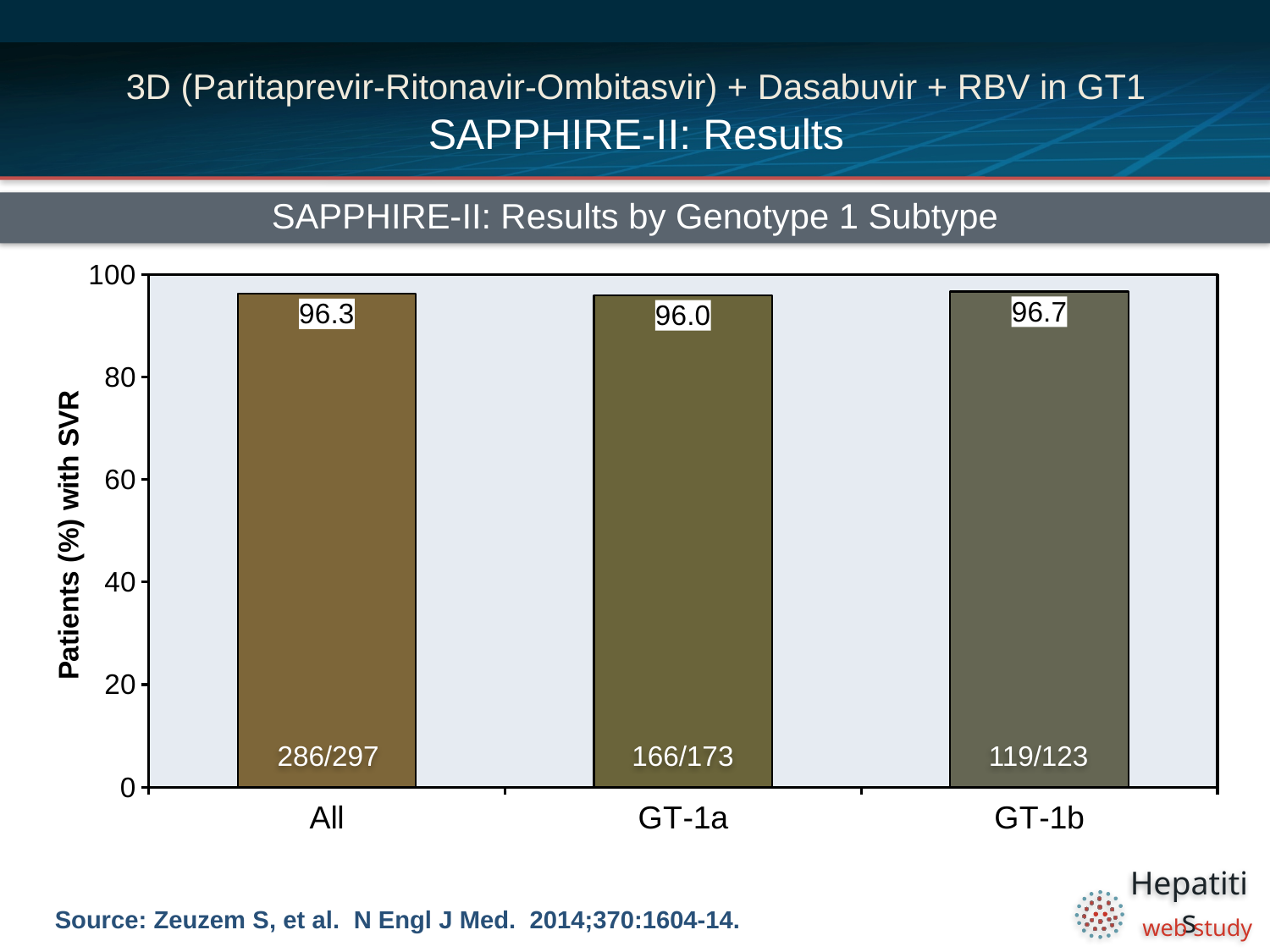
What fraction of patients is printed on the GT-1a bar? 166/173 Which category has the lowest SVR rate according to the data labels? GT-1a What is the SVR rate shown for GT-1a? 96.0 Is the SVR rate for GT-1a greater or less than 80? greater How many categories are shown on the x axis? 3 What type of chart is shown on the slide? Bar chart Which genotype subtype has the highest SVR rate according to the data labels? GT-1b What is the label of the y axis? Patients (%) with SVR What is the SVR rate shown for the All group? 96.3 What fraction of patients is printed on the All bar? 286/297 What is the difference in SVR rate between GT-1b and GT-1a? 0.7 What is the SVR rate shown for GT-1b? 96.7